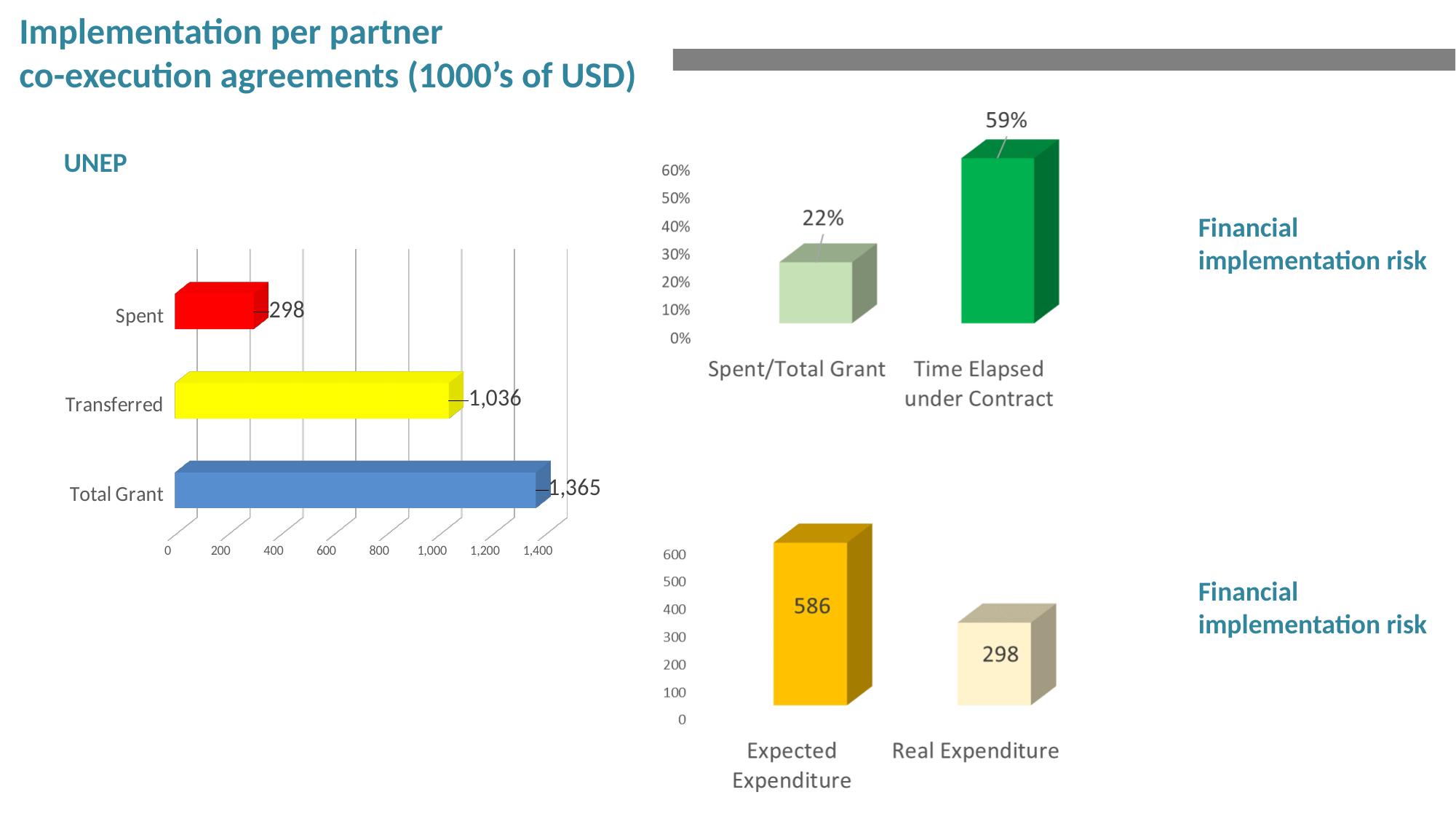
In the UNEP chart on the left, what colour is the Spent bar? Red In the UNEP chart on the left, what is the value for Transferred? 1,036 In the top-right chart, what is the value for Spent/Total Grant? 22% In the UNEP chart on the left, what is the difference between Total Grant and Transferred? 329 In the top-right chart, what is the value for Time Elapsed under Contract? 59% In the UNEP chart on the left, what is the value for Total Grant? 1,365 In the UNEP chart on the left, which category has the lowest value? Spent In the bottom-right chart, what is the difference between Expected Expenditure and Real Expenditure? 288 In the top-right chart, which is larger, Spent/Total Grant or Time Elapsed under Contract? Time Elapsed under Contract In the bottom-right chart, what is the value for Expected Expenditure? 586 In the UNEP chart on the left, how many categories are shown? 3 What kind of chart is the UNEP chart on the left? Bar chart